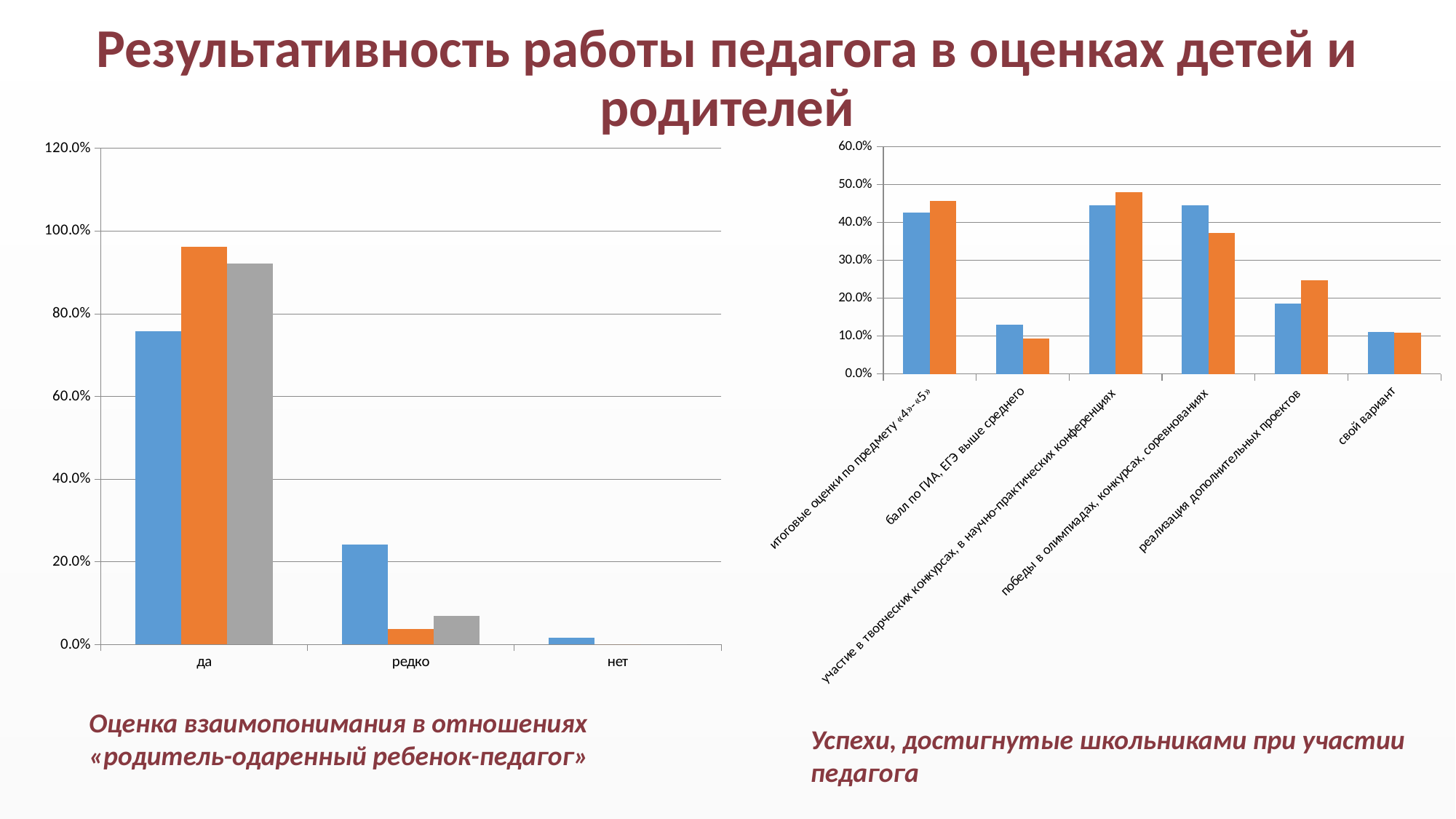
In the left chart (Оценка взаимопонимания), which category has the tallest bars? да In the left chart (Оценка взаимопонимания), is the blue bar for «да» greater or less than 60.0%? greater In the left chart (Оценка взаимопонимания), is the blue bar for «редко» greater or less than 40.0%? less In the right chart (Успехи, достигнутые школьниками), which is larger for «победы в олимпиадах, конкурсах, соревнованиях»: the blue bar or the orange bar? the blue bar In the left chart (Оценка взаимопонимания), which category has the lowest values overall? нет What is the maximum value shown on the vertical axis of the right chart (Успехи, достигнутые школьниками)? 60.0% In the right chart (Успехи, достигнутые школьниками), is the orange bar for «реализация дополнительных проектов» greater or less than 20.0%? greater How many categories are shown on the x axis of the right chart (Успехи, достигнутые школьниками при участии педагога)? 6 How many categories are shown on the x axis of the left chart (Оценка взаимопонимания)? 3 In the left chart (Оценка взаимопонимания), which is larger for «да»: the blue bar or the orange bar? the orange bar What kind of chart is the left chart (Оценка взаимопонимания в отношениях «родитель-одаренный ребенок-педагог»)? bar chart